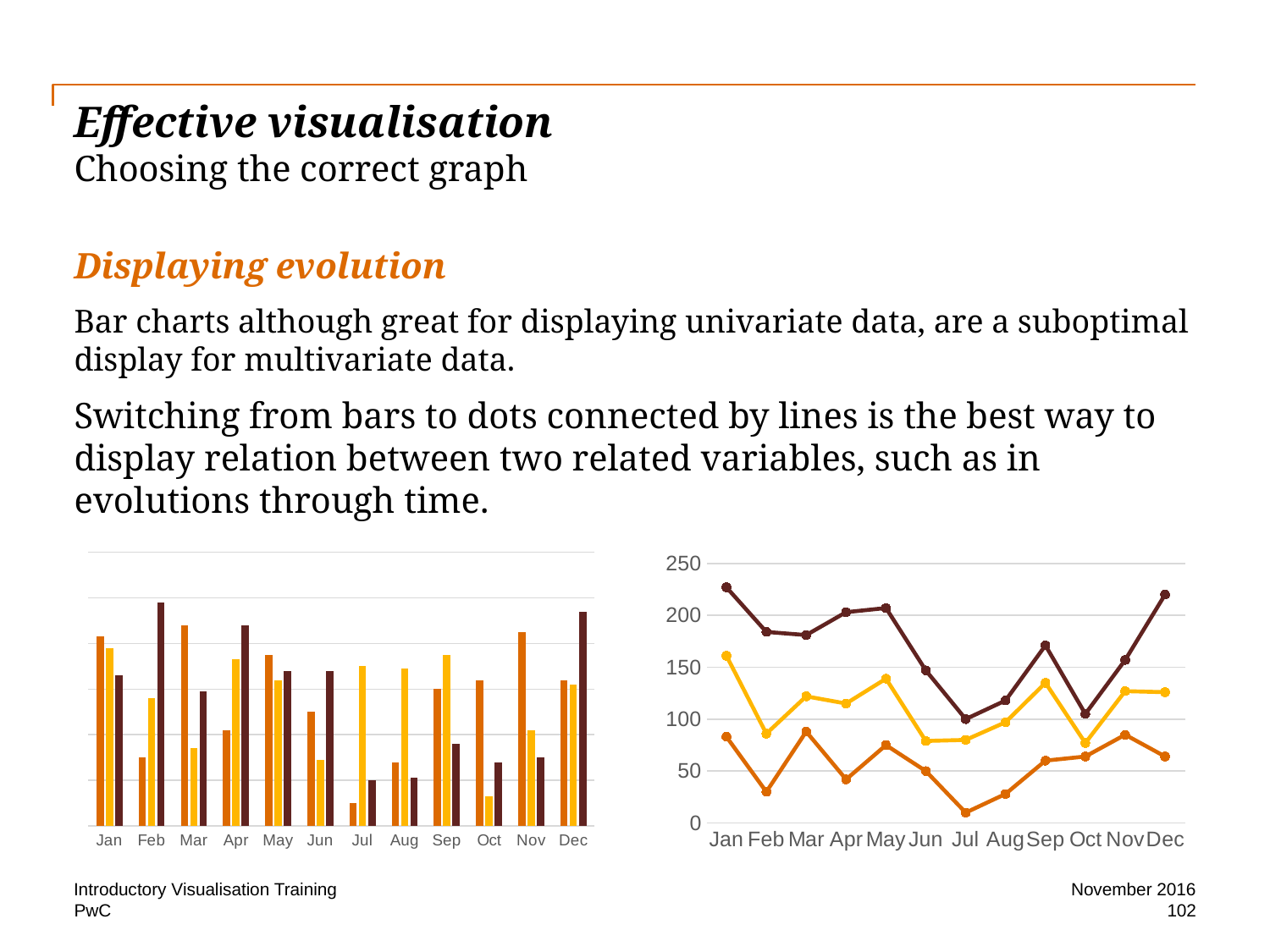
How many bars are plotted for each month in the bar chart on the left? 3 In the line chart on the right, in which month is the orange line at its lowest? Jul In the line chart on the right, is the value of the orange line in Jul greater or less than 50? less How many months are shown on the x axis of the line chart on the right? 12 In the line chart on the right, is the value of the yellow line in Jan greater or less than 150? greater In the line chart on the right, in which month is the yellow line at its highest? Jan What kind of chart is the chart on the right of the slide? line chart How many lines are plotted in the line chart on the right? 3 What kind of chart is the chart on the left of the slide? bar chart In the line chart on the right, which line has the higher value in May, the dark brown line or the orange line? the dark brown line In the line chart on the right, is the value of the dark brown line in Jan greater or less than 200? greater